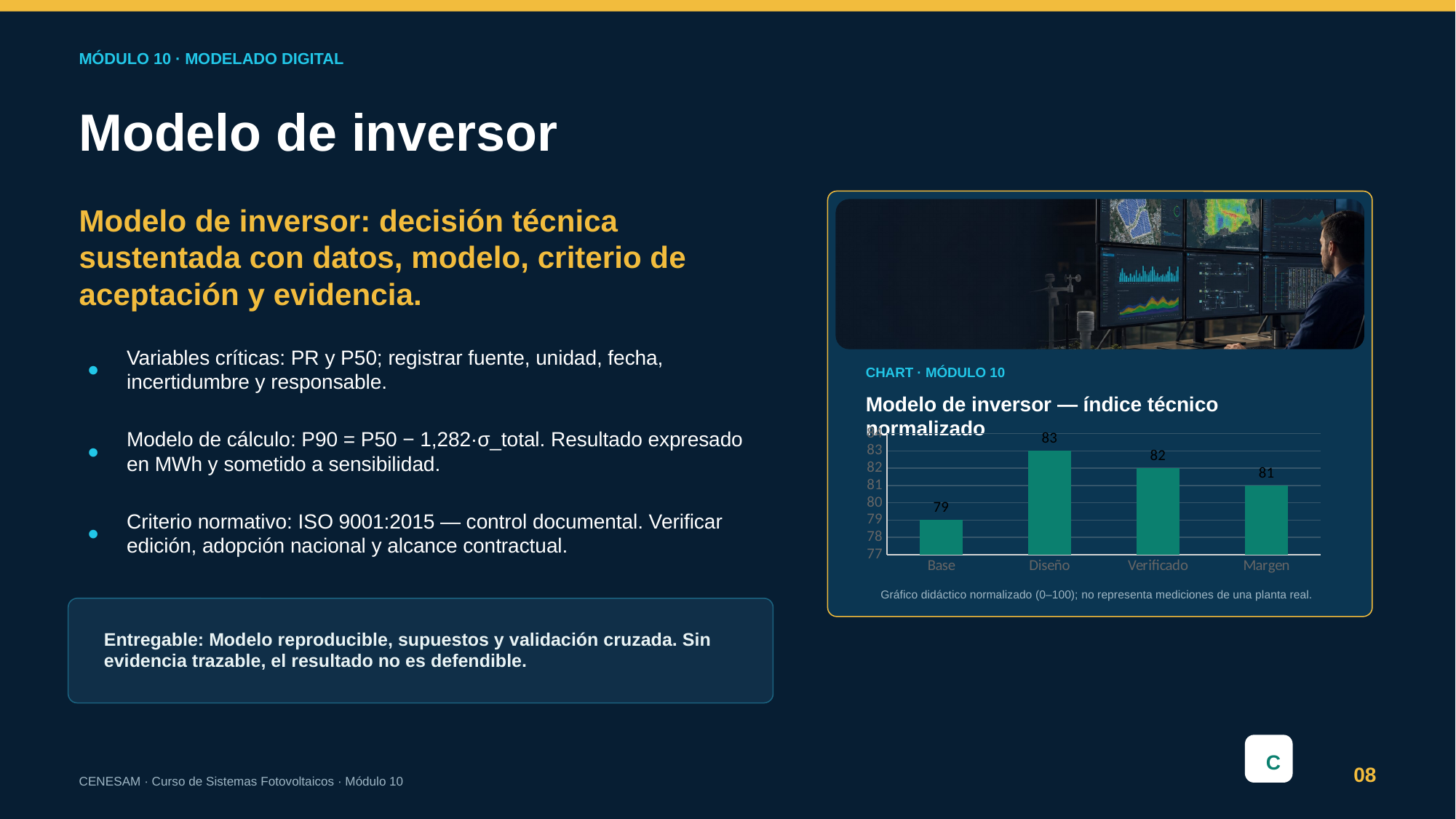
Which is larger, the value for Verificado or the value for Margen? Verificado What is the value for Verificado? 82 What is the value for Base? 79 How many categories are shown on the x axis? 4 What is the value for Diseño? 83 What is the value for Margen? 81 What is the title of the chart? Modelo de inversor — índice técnico normalizado Which category has the highest value? Diseño What kind of chart is shown? bar chart Is the value for Base greater or less than 80? less What is the difference between the values for Diseño and Base? 4 Which category has the lowest value? Base